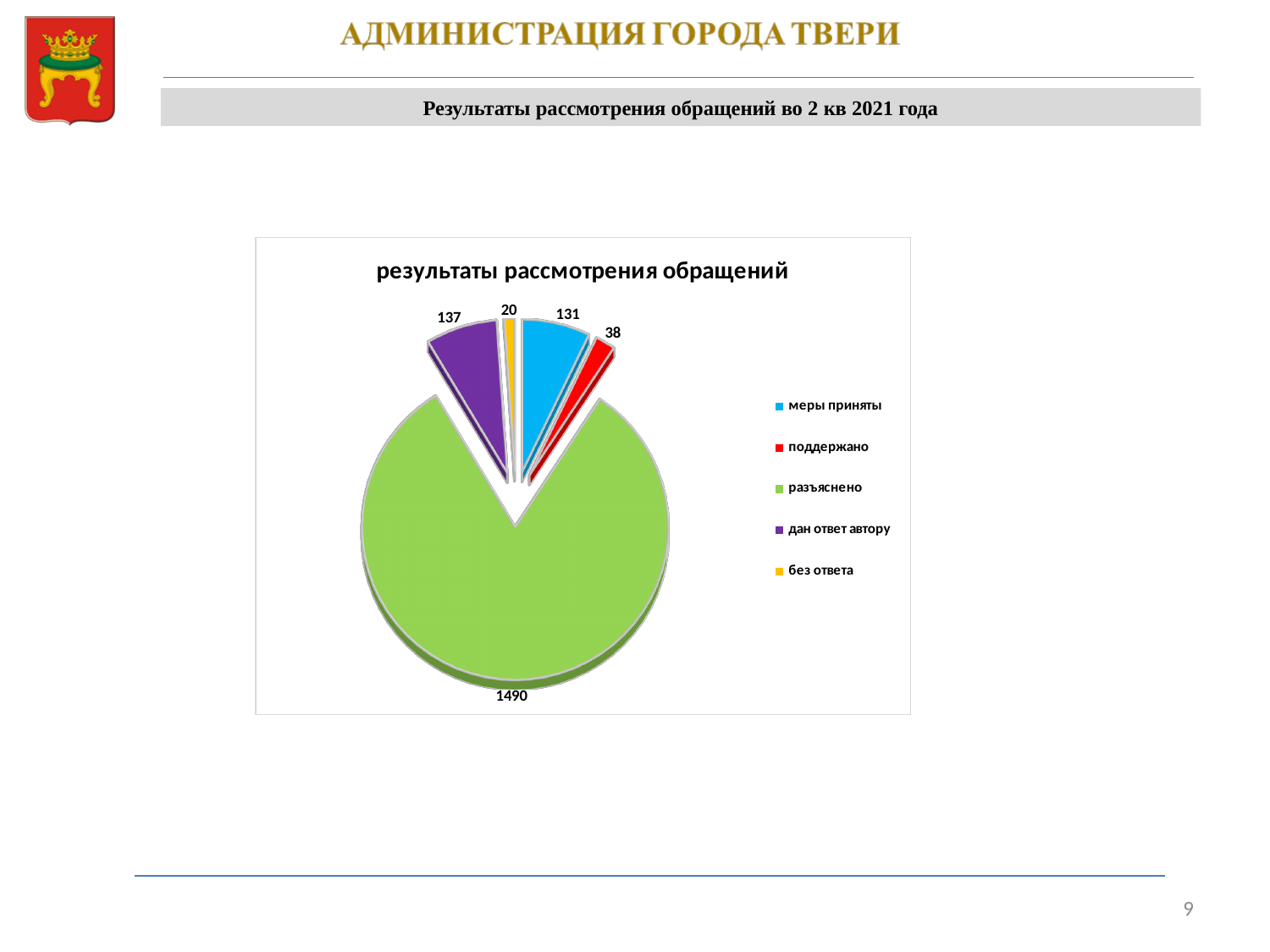
Which category has the smallest slice? без ответа What is the difference between the values for дан ответ автору and меры приняты? 6 What is the value for поддержано? 38 Which category has the largest slice? разъяснено What is the value for меры приняты? 131 Which is larger, поддержано or без ответа? поддержано What is the value for дан ответ автору? 137 How many categories does the legend list? 5 What is the value for разъяснено? 1490 What is the value for без ответа? 20 What is the title of the chart? результаты рассмотрения обращений What kind of chart is shown on the slide? pie chart